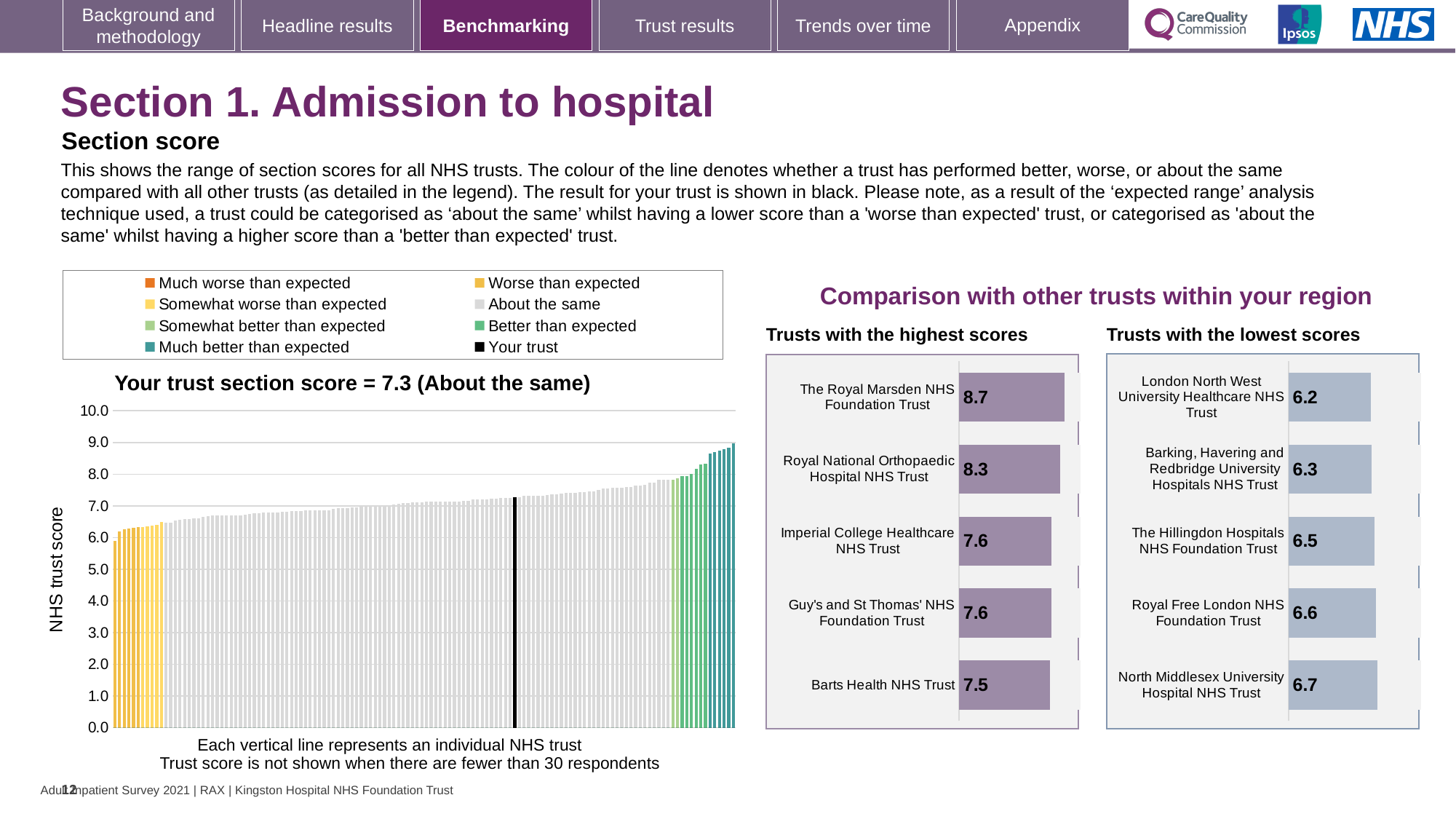
In the 'Trusts with the lowest scores' chart, what is the score for London North West University Healthcare NHS Trust? 6.2 In the 'Trusts with the lowest scores' chart, which trust has the lowest score? London North West University Healthcare NHS Trust In the 'Your trust section score' chart on the left, do the values rise or fall from left to right along the x axis? Rise In the 'Trusts with the lowest scores' chart, what is the difference between the scores of North Middlesex University Hospital NHS Trust and London North West University Healthcare NHS Trust? 0.5 How many entries does the legend above the 'Your trust section score' chart list? 8 In the 'Trusts with the lowest scores' chart, which has the larger score: The Hillingdon Hospitals NHS Foundation Trust or Royal Free London NHS Foundation Trust? Royal Free London NHS Foundation Trust How many trusts are shown in the 'Trusts with the highest scores' chart? 5 In the 'Trusts with the highest scores' chart, what is the score for The Royal Marsden NHS Foundation Trust? 8.7 In the 'Trusts with the highest scores' chart, what is the difference between the scores of The Royal Marsden NHS Foundation Trust and Barts Health NHS Trust? 1.2 What kind of chart is the 'Your trust section score' chart on the left? Bar chart According to the title of the chart on the left, what is your trust's section score? 7.3 In the 'Trusts with the highest scores' chart, which trust has the highest score? The Royal Marsden NHS Foundation Trust